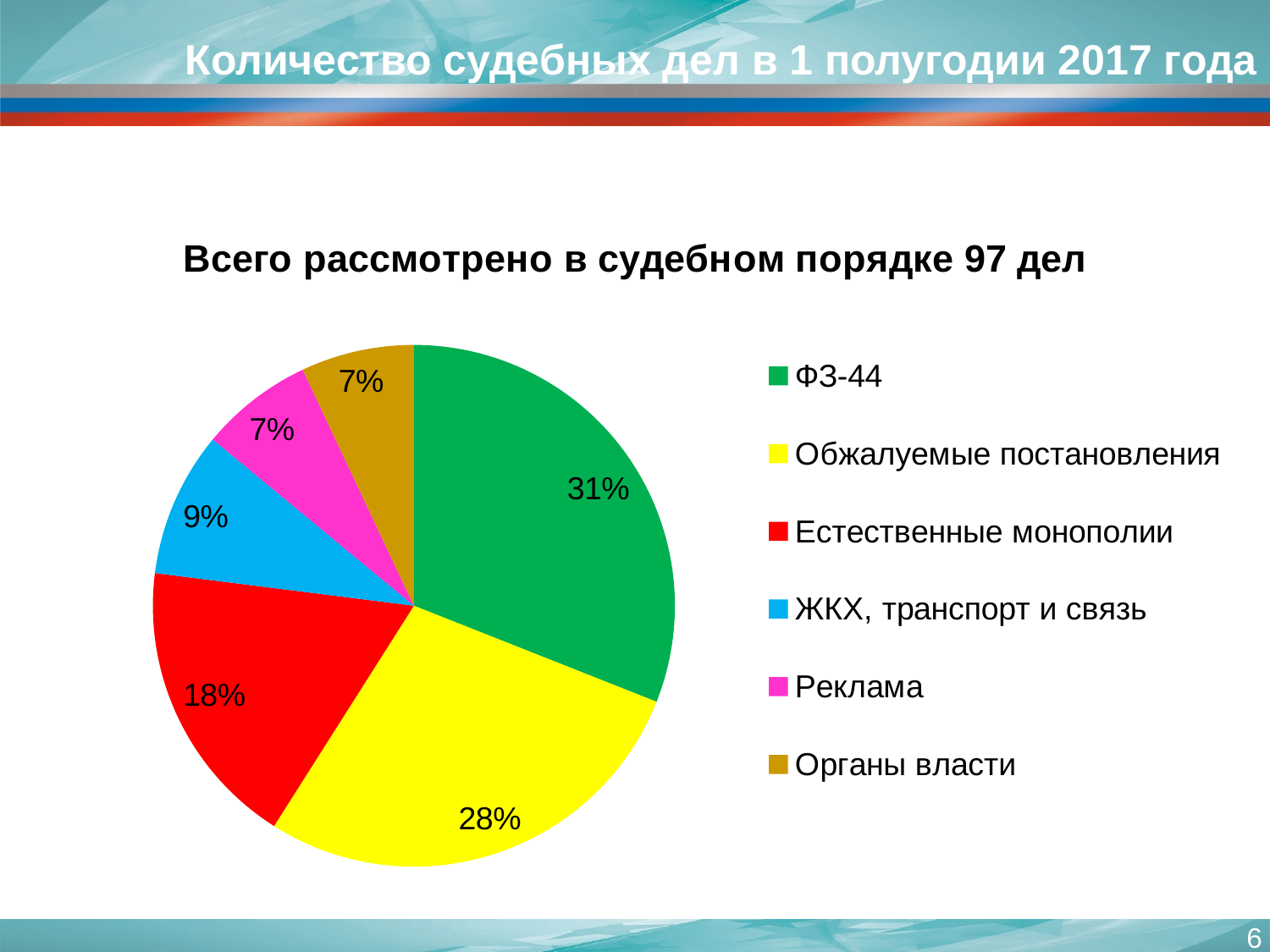
What share of the pie does Естественные монополии take? 18% What share of the pie does ЖКХ, транспорт и связь take? 9% What share of the pie does Обжалуемые постановления take? 28% How many entries does the legend list? 6 What colour is the Органы власти slice in the pie chart? gold How many slices does the pie chart have? 6 Which category has the largest slice of the pie? ФЗ-44 Which slice is larger: Обжалуемые постановления or ЖКХ, транспорт и связь? Обжалуемые постановления What is the difference in percentage points between the ФЗ-44 slice and the Естественные монополии slice? 13 What kind of chart is shown on the slide? pie chart